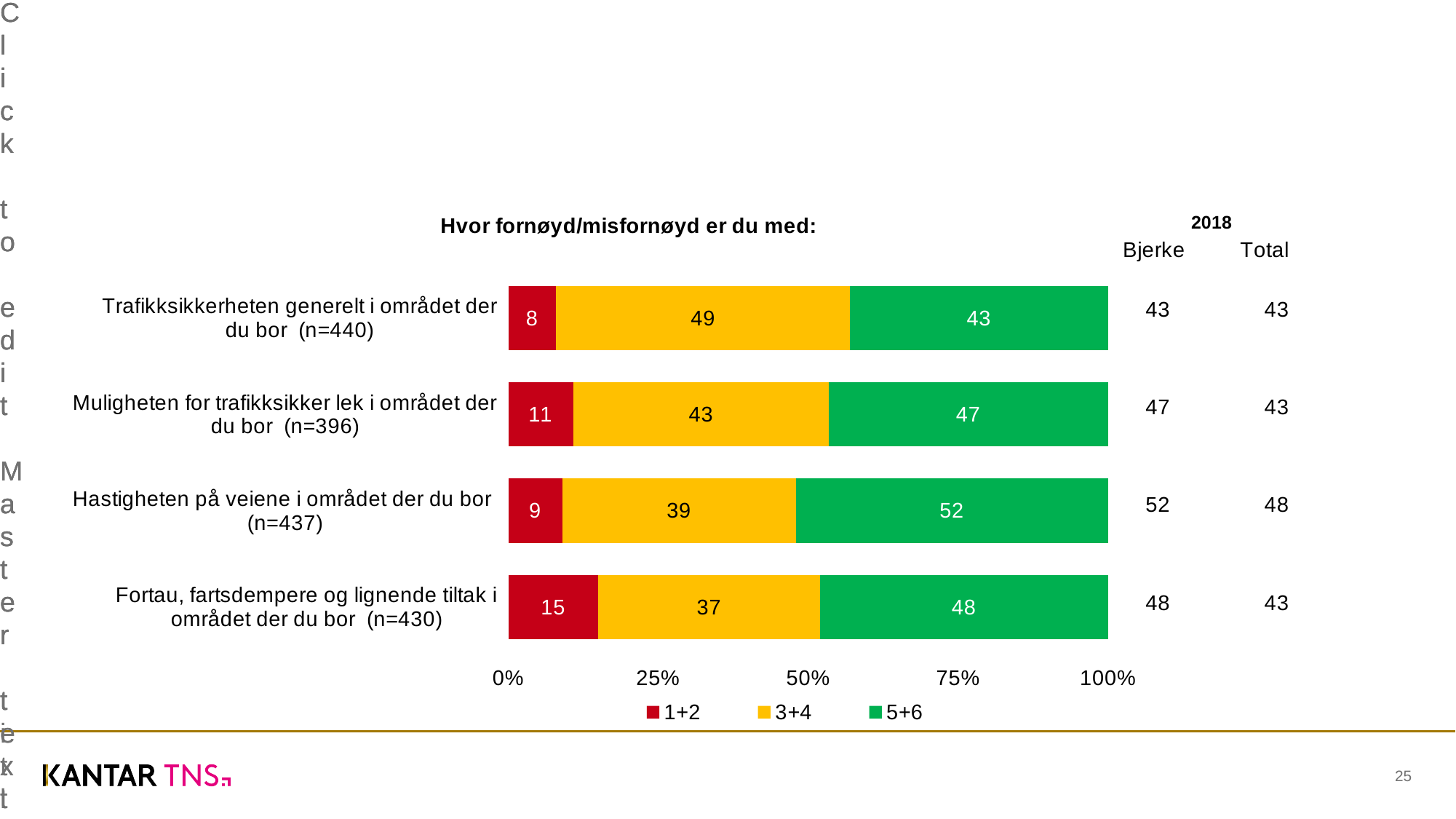
What is the value of the 5+6 segment for "Hastigheten på veiene i området der du bor (n=437)"? 52 What colour represents the 1+2 series in the chart? Red What kind of chart is shown on the slide? Stacked bar chart How many categories are plotted in the chart? 4 Which is larger: the 5+6 value for "Muligheten for trafikksikker lek i området der du bor (n=396)" or for "Trafikksikkerheten generelt i området der du bor (n=440)"? Muligheten for trafikksikker lek i området der du bor (n=396) What is the total of the stacked bar for "Muligheten for trafikksikker lek i området der du bor (n=396)"? 101 Which category has the lowest 1+2 value? Trafikksikkerheten generelt i området der du bor (n=440) What is the value of the 3+4 segment for "Trafikksikkerheten generelt i området der du bor (n=440)"? 49 What is the value of the 1+2 segment for "Fortau, fartsdempere og lignende tiltak i området der du bor (n=430)"? 15 Which category has the highest 5+6 value? Hastigheten på veiene i området der du bor (n=437) What is the difference between the 3+4 values for "Trafikksikkerheten generelt i området der du bor (n=440)" and "Fortau, fartsdempere og lignende tiltak i området der du bor (n=430)"? 12 How many series does the legend list? 3